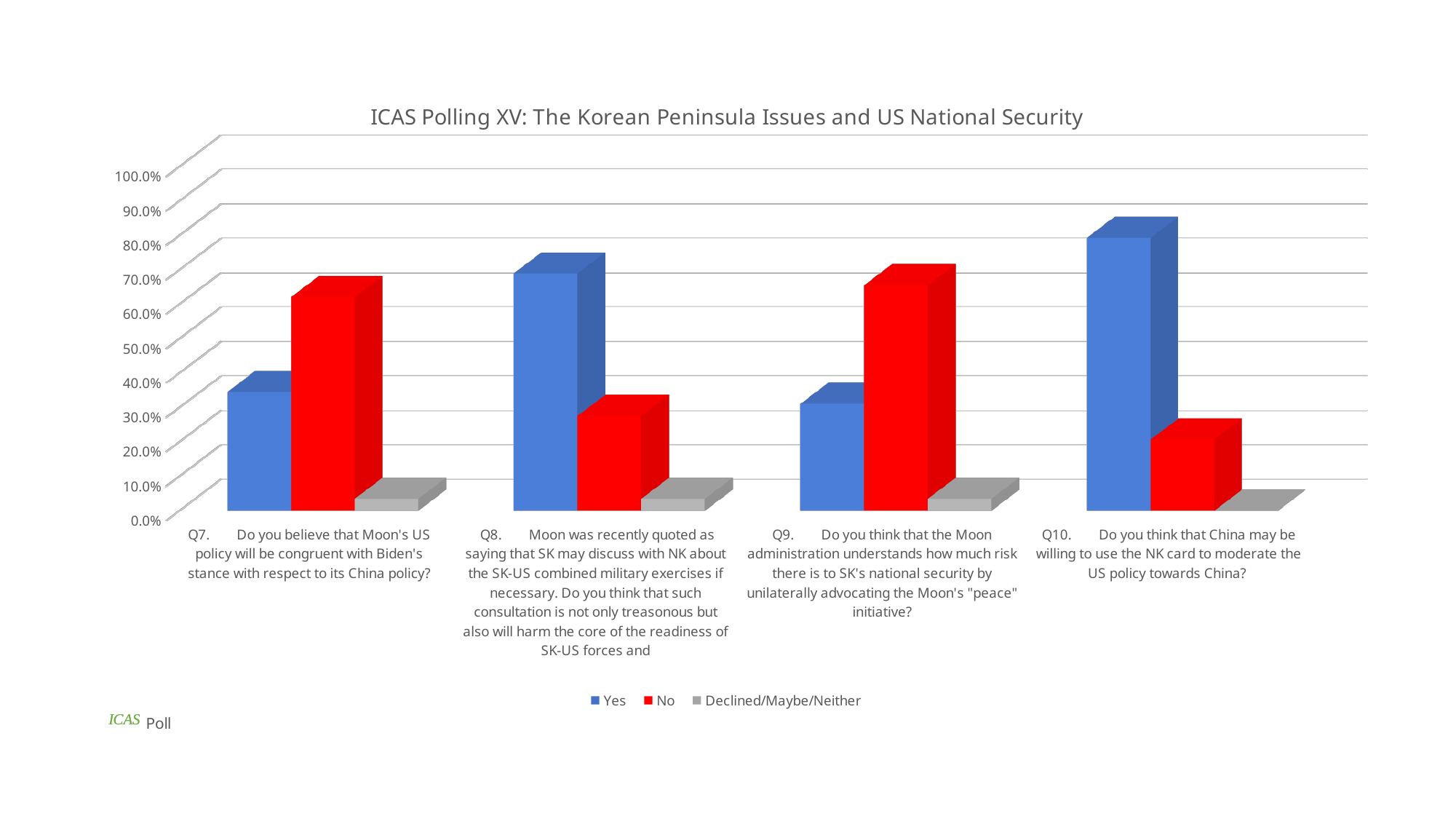
Which series is shown in red in the legend? No For Q8, which is larger, the Yes value or the No value? Yes Is the No value for Q9 greater or less than 50.0%? greater What kind of chart is shown on the slide? bar chart How many questions (categories) are plotted on the x axis? 4 Is the Yes value for Q10 greater or less than 70.0%? greater How many series does the legend list? 3 For Q7, which is larger, the Yes value or the No value? No Which question has the highest Yes value? Q10 What is the title of the chart? ICAS Polling XV: The Korean Peninsula Issues and US National Security For Q10, which is larger, the Yes value or the No value? Yes Which question has the lowest No value? Q10